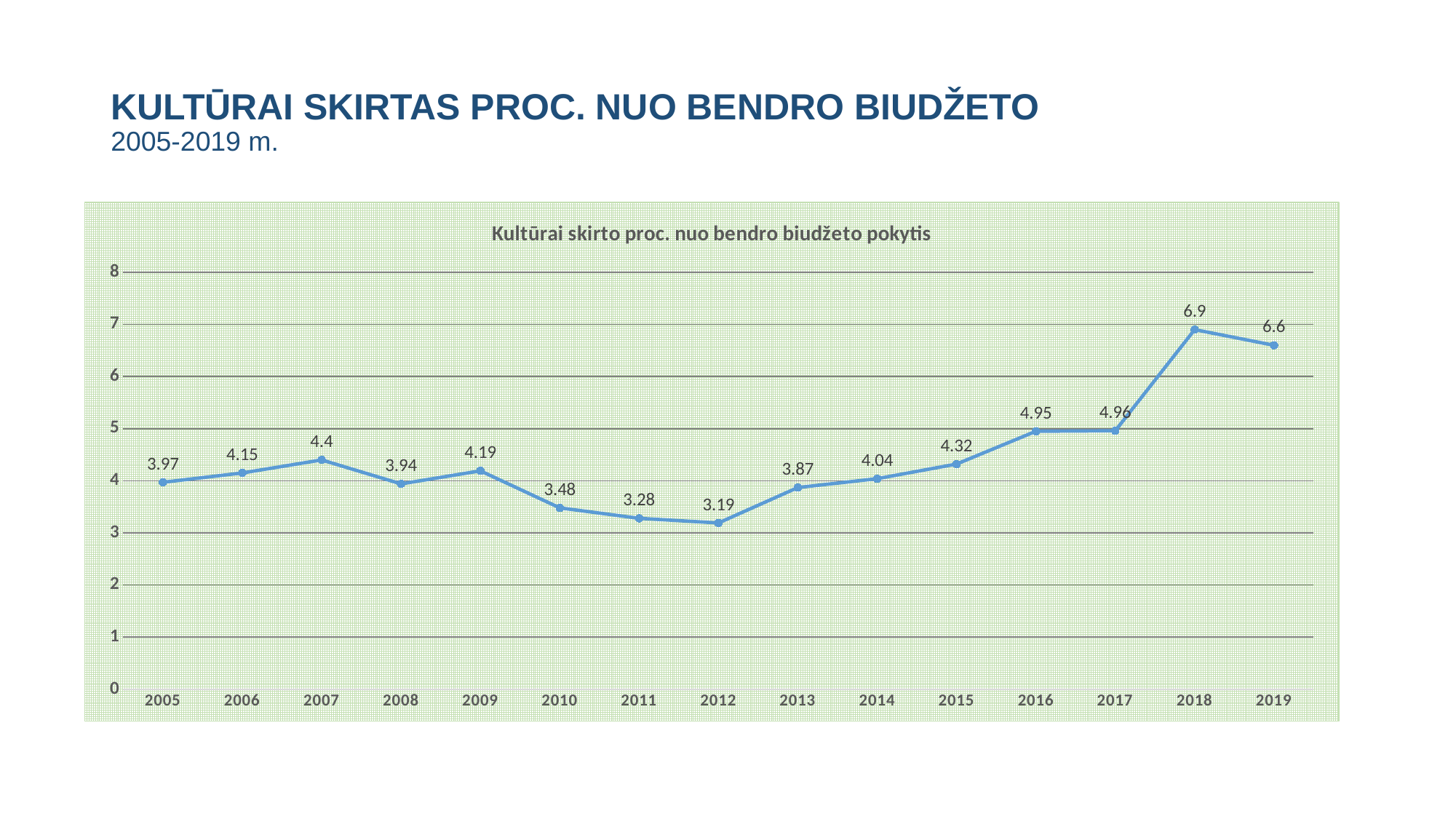
What is the title of the chart? Kultūrai skirto proc. nuo bendro biudžeto pokytis What is the value for 2018? 6.9 How many years are plotted on the chart? 15 What kind of chart is shown? line chart What is the value for 2007? 4.4 Which year has the lowest value? 2012 What is the difference between the values for 2018 and 2019? 0.3 What is the value for 2012? 3.19 Which is larger, the value for 2009 or the value for 2010? 2009 What is the difference between the values for 2013 and 2012? 0.68 Is the value for 2016 greater or less than 4? greater Which year has the highest value? 2018